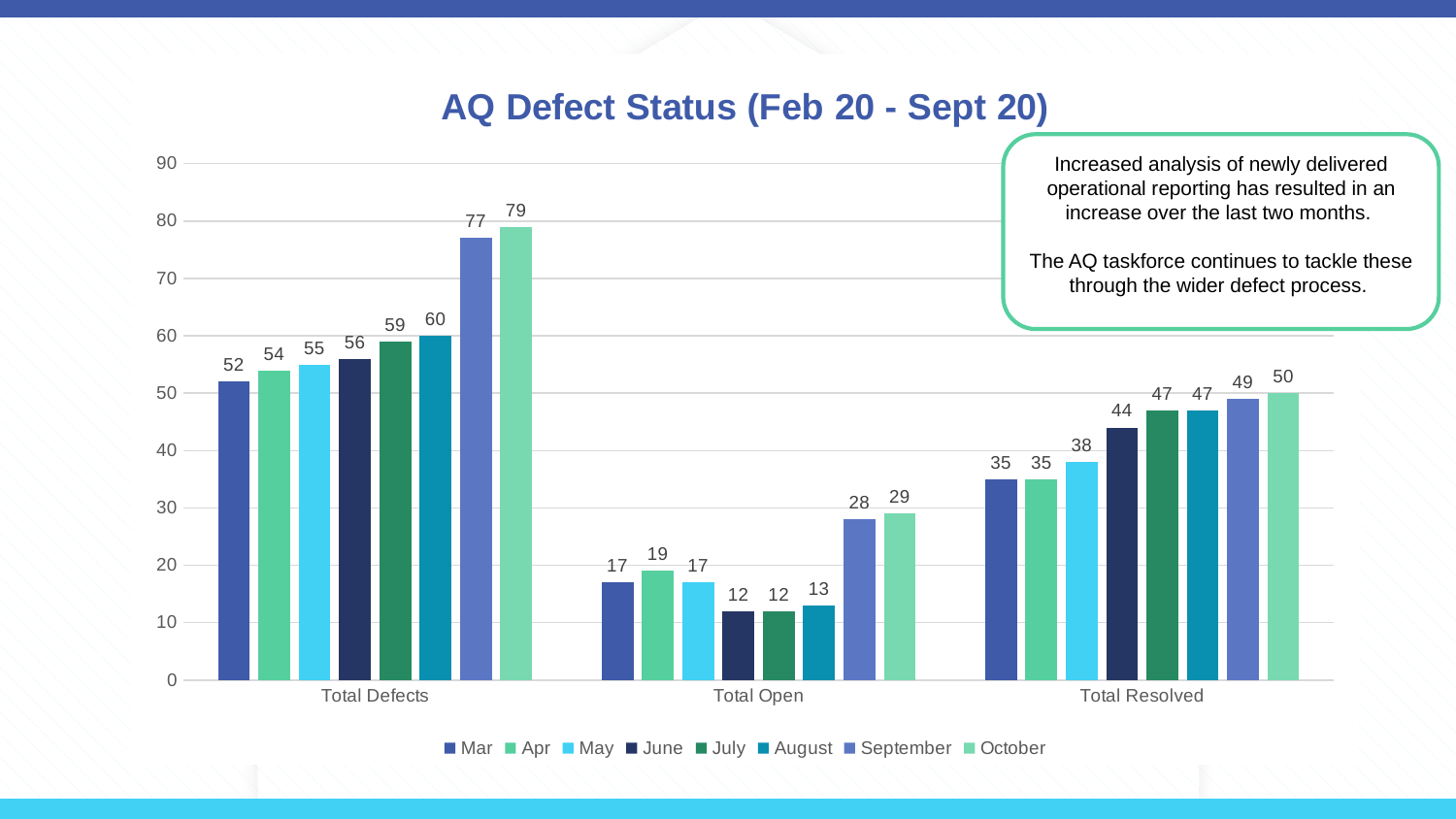
What kind of chart is shown on the slide? Bar chart Which month has the lowest Total Resolved value? Mar and Apr (35) How many series does the legend list? 8 Is the Total Resolved value for July greater or less than 40? greater What is the Total Resolved value for September? 49 What is the title of the chart? AQ Defect Status (Feb 20 - Sept 20) Which month has the highest Total Defects value? October What is the Total Defects value for October? 79 What is the difference between the Total Defects values for October and Mar? 27 How many categories are shown on the x axis? 3 Which is larger: the Total Open value for September or the Total Open value for Apr? September What is the Total Open value for June? 12